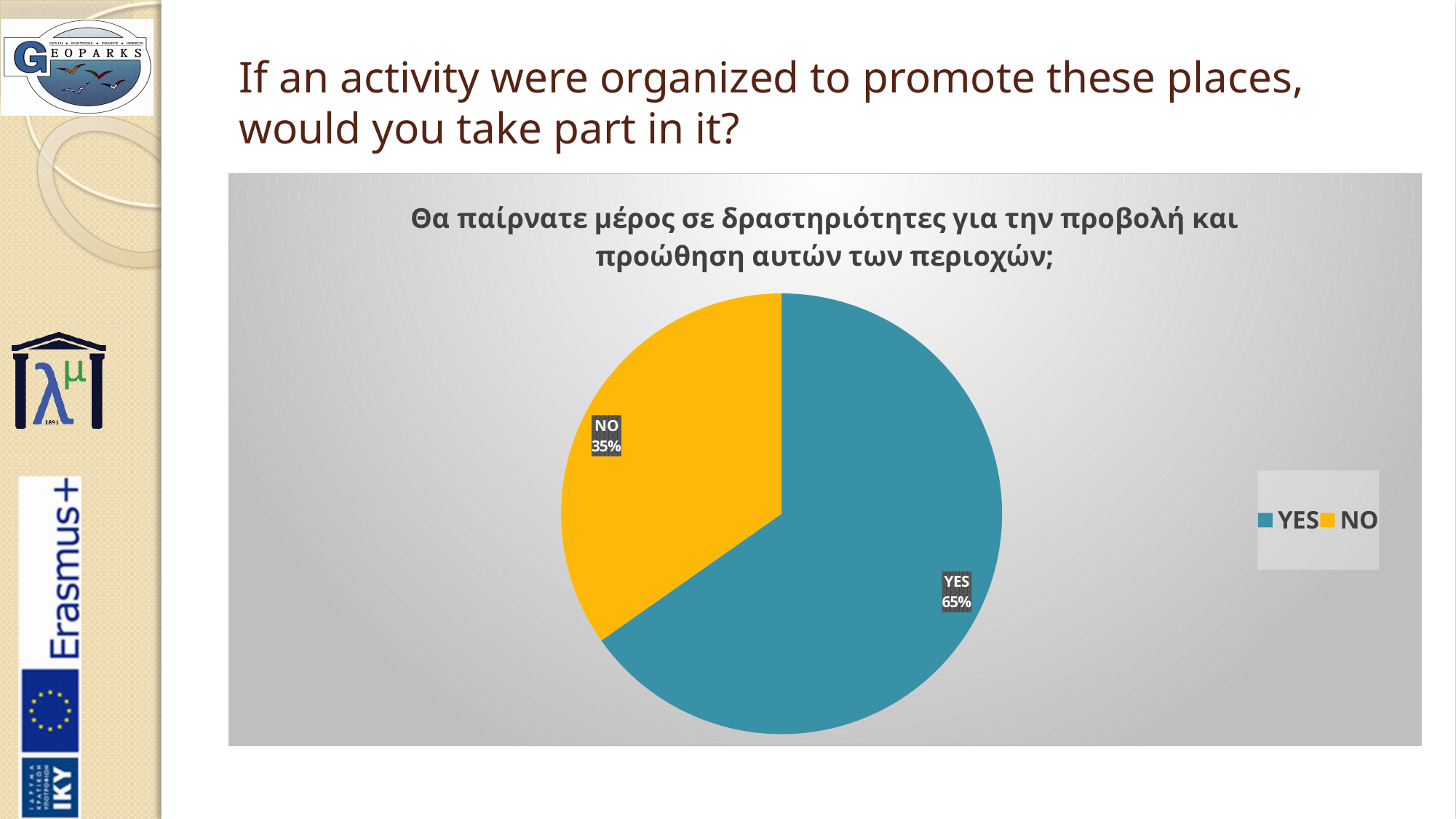
What colour is the YES slice? Teal/blue What colour is the NO slice? Orange/yellow What percentage of respondents answered NO? 35% What is the difference in percentage points between the YES and NO shares? 30 What percentage of respondents answered YES? 65% What share of the pie does the YES slice represent? 65% How many entries does the legend list? 2 Which response has the smallest share of the pie? NO Which is larger, the YES share or the NO share? YES What kind of chart is shown on the slide? Pie chart How many slices does the pie chart have? 2 Which response has the largest share of the pie? YES